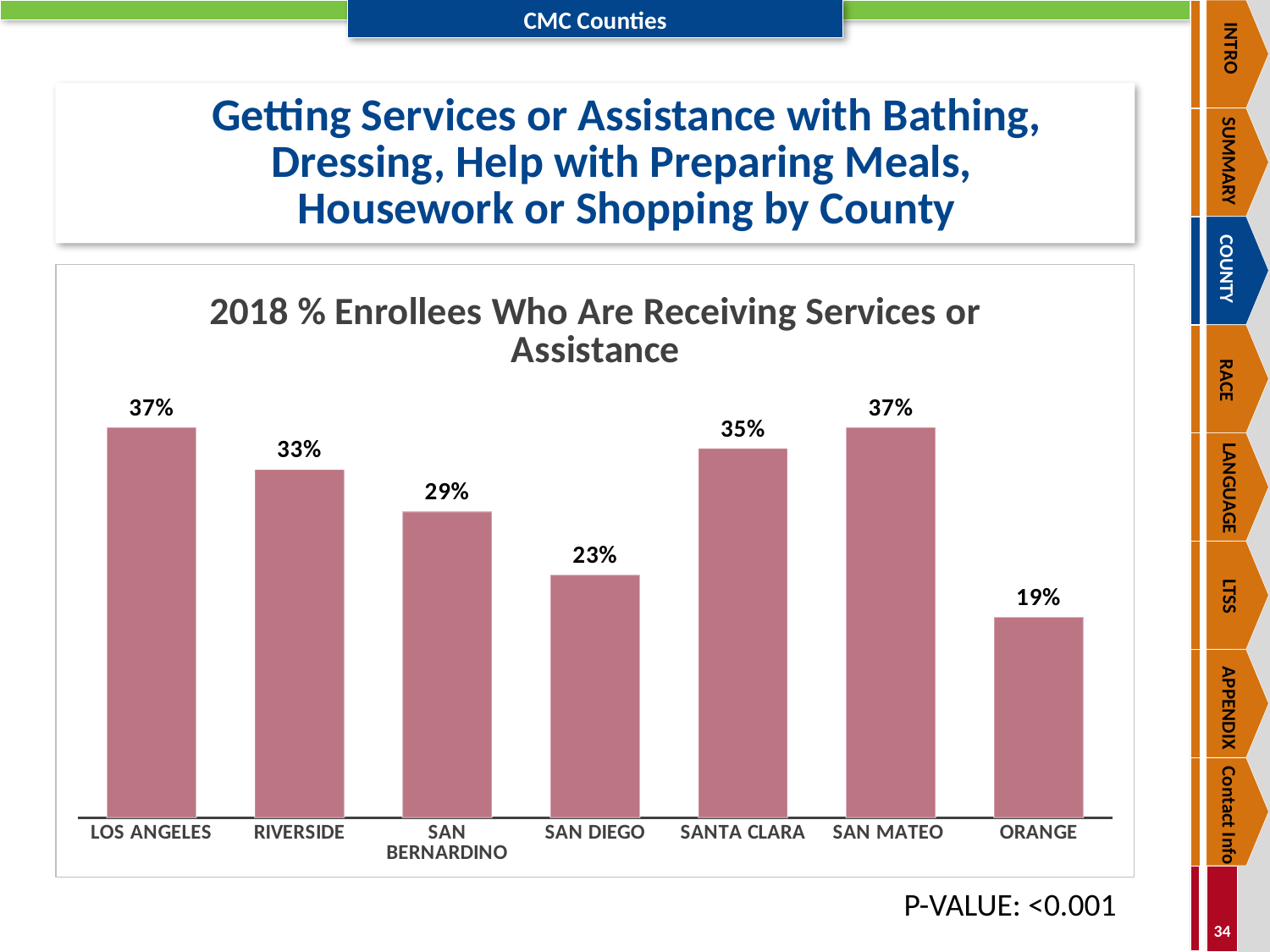
What is the value shown for Santa Clara? 35% What is the value shown for Orange? 19% What is the difference between the values for Santa Clara and San Diego? 12% Which county has the lowest percentage of enrollees receiving services or assistance? Orange What is the difference between the values for Los Angeles and Orange? 18% How many counties are shown in the chart? 7 What percentage of enrollees in Los Angeles are receiving services or assistance? 37% Which has a higher value, Riverside or San Bernardino? Riverside What type of chart is shown on the slide? Bar chart What is the value shown for San Diego? 23% What is the value shown for San Bernardino? 29% What is the value shown for Riverside? 33%